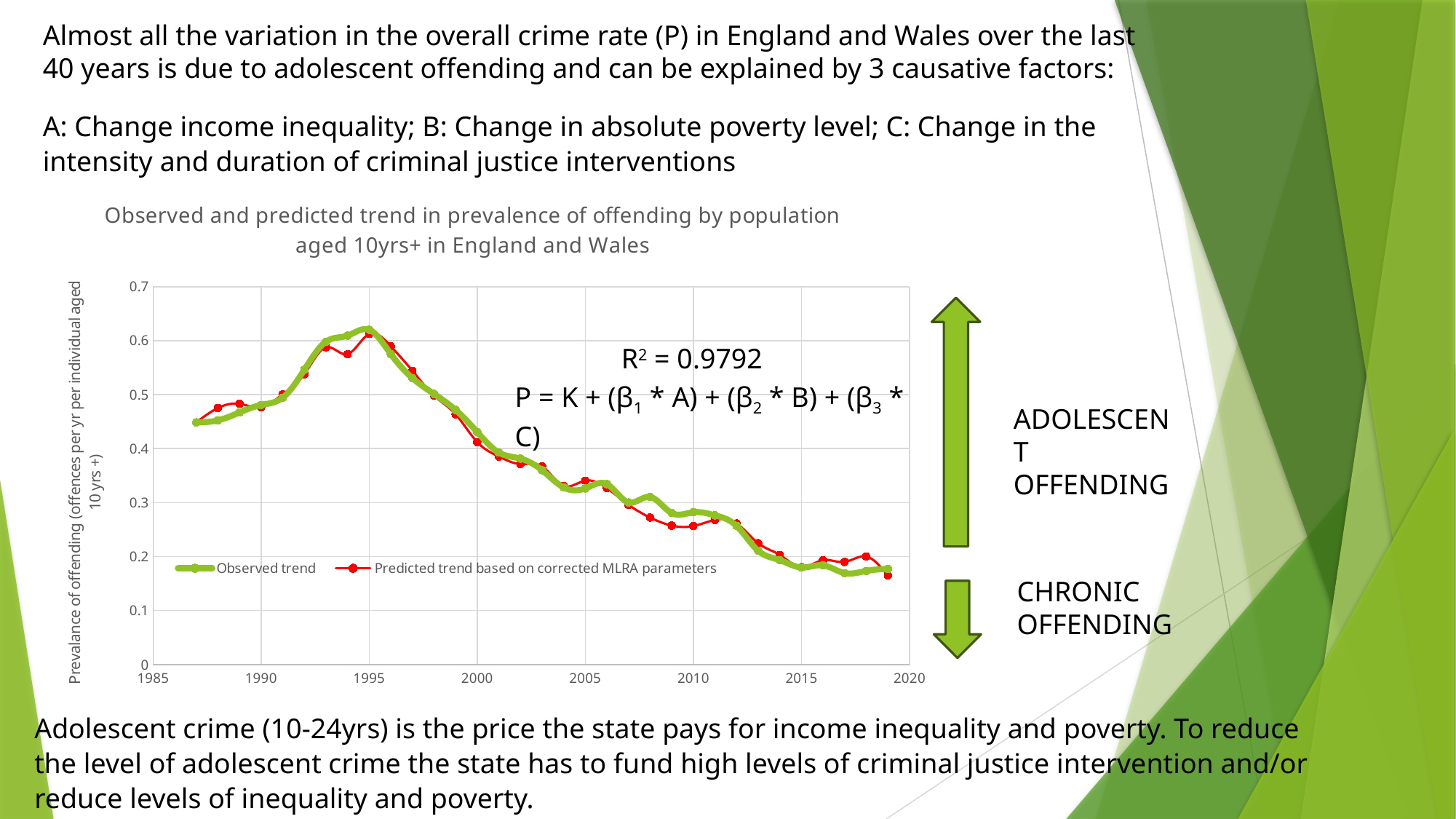
Which is larger, the Observed trend value in 1995 or the Observed trend value in 2010? 1995 Is the Observed trend value in 2019 greater or less than 0.2? less What are the two series named in the chart legend? Observed trend; Predicted trend based on corrected MLRA parameters Does the Observed trend rise or fall between 1995 and 2019? fall Is the Observed trend value in 1995 greater or less than 0.5? greater How many series does the chart legend list? 2 What kind of chart is shown on the slide? line chart Is the Observed trend value in 2005 greater or less than 0.3? greater In which year does the Observed trend reach its highest value? 1995 What R² value is printed on the chart? 0.9792 Does the Observed trend rise or fall between 1987 and 1995? rise